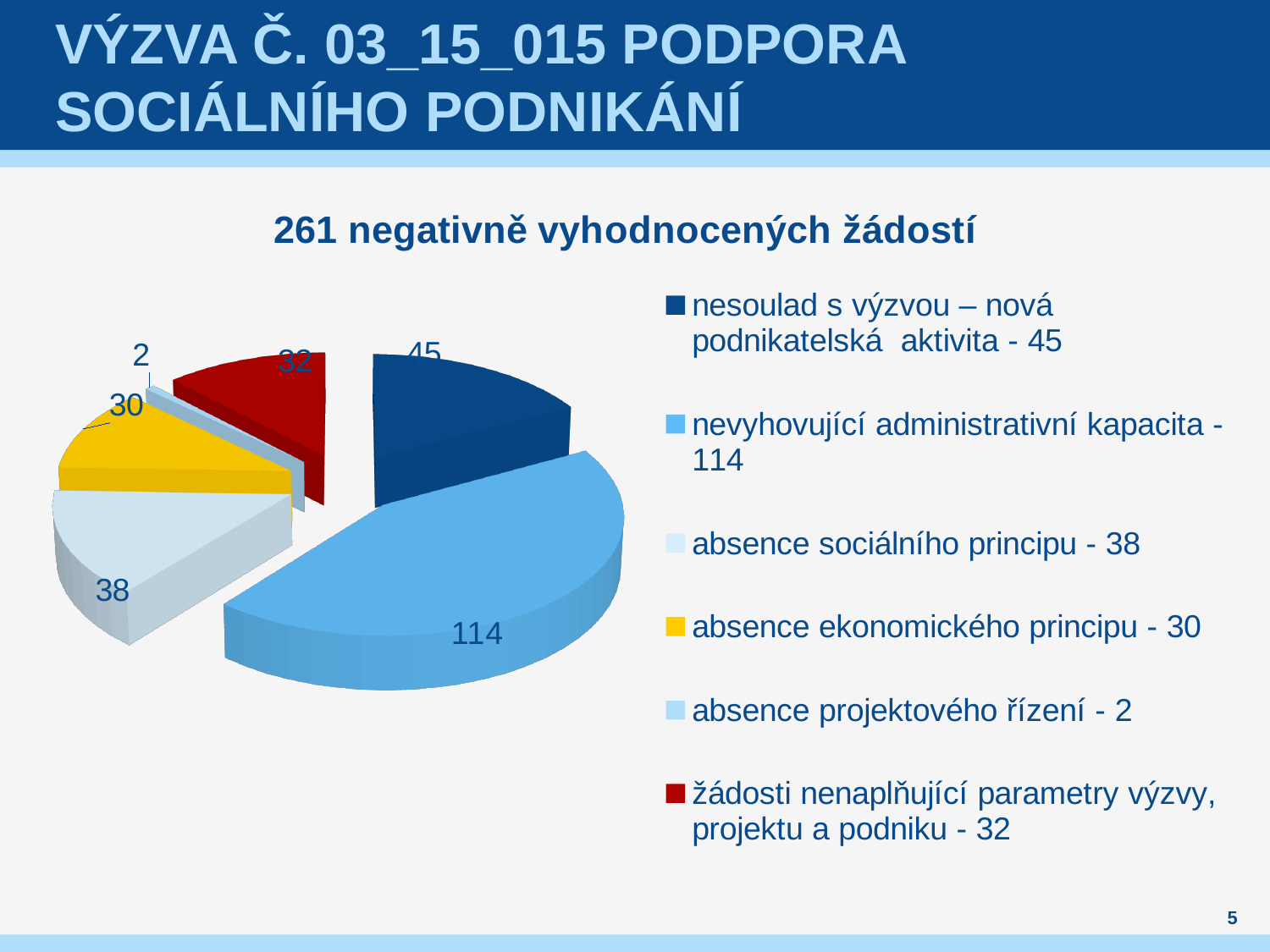
What is the value for "absence sociálního principu"? 38 What kind of chart is shown on the slide? pie chart Which is larger: the value for "absence sociálního principu" or the value for "absence ekonomického principu"? absence sociálního principu Which category has the largest slice of the pie? nevyhovující administrativní kapacita What is the value for "absence projektového řízení"? 2 What is the value for "nevyhovující administrativní kapacita"? 114 Which category has the smallest slice of the pie? absence projektového řízení How many categories does the pie chart have? 6 What is the value for "žádosti nenaplňující parametry výzvy, projektu a podniku"? 32 What is the difference between the values for "nevyhovující administrativní kapacita" and "nesoulad s výzvou – nová podnikatelská aktivita"? 69 What is the total of all the slices in the pie chart? 261 What is the title of the chart? 261 negativně vyhodnocených žádostí